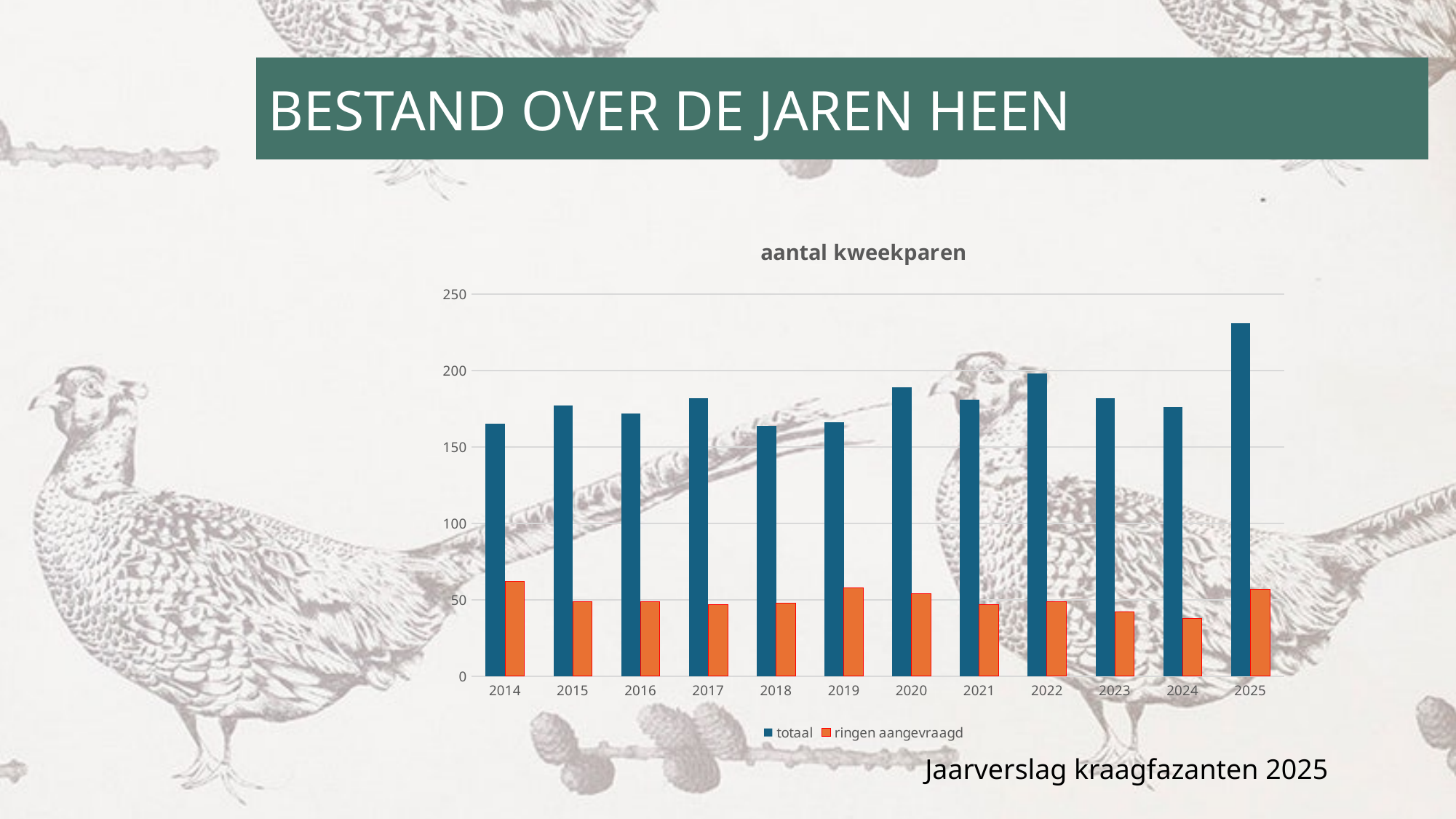
Which year has the highest value for the 'ringen aangevraagd' series? 2014 What is the title of the chart? aantal kweekparen Is the 'ringen aangevraagd' value for 2024 greater or less than 50? less Is the 'ringen aangevraagd' value for 2014 greater or less than 50? greater Which is larger, the 'totaal' value for 2025 or for 2024? 2025 Which series is shown in blue in the chart? totaal Is the 'totaal' value for 2025 greater or less than 200? greater Which year has the lowest value for the 'ringen aangevraagd' series? 2024 How many series does the legend list? 2 Which year has the highest value for the 'totaal' series? 2025 How many years are shown on the x axis of the chart? 12 What type of chart is shown on the slide? bar chart